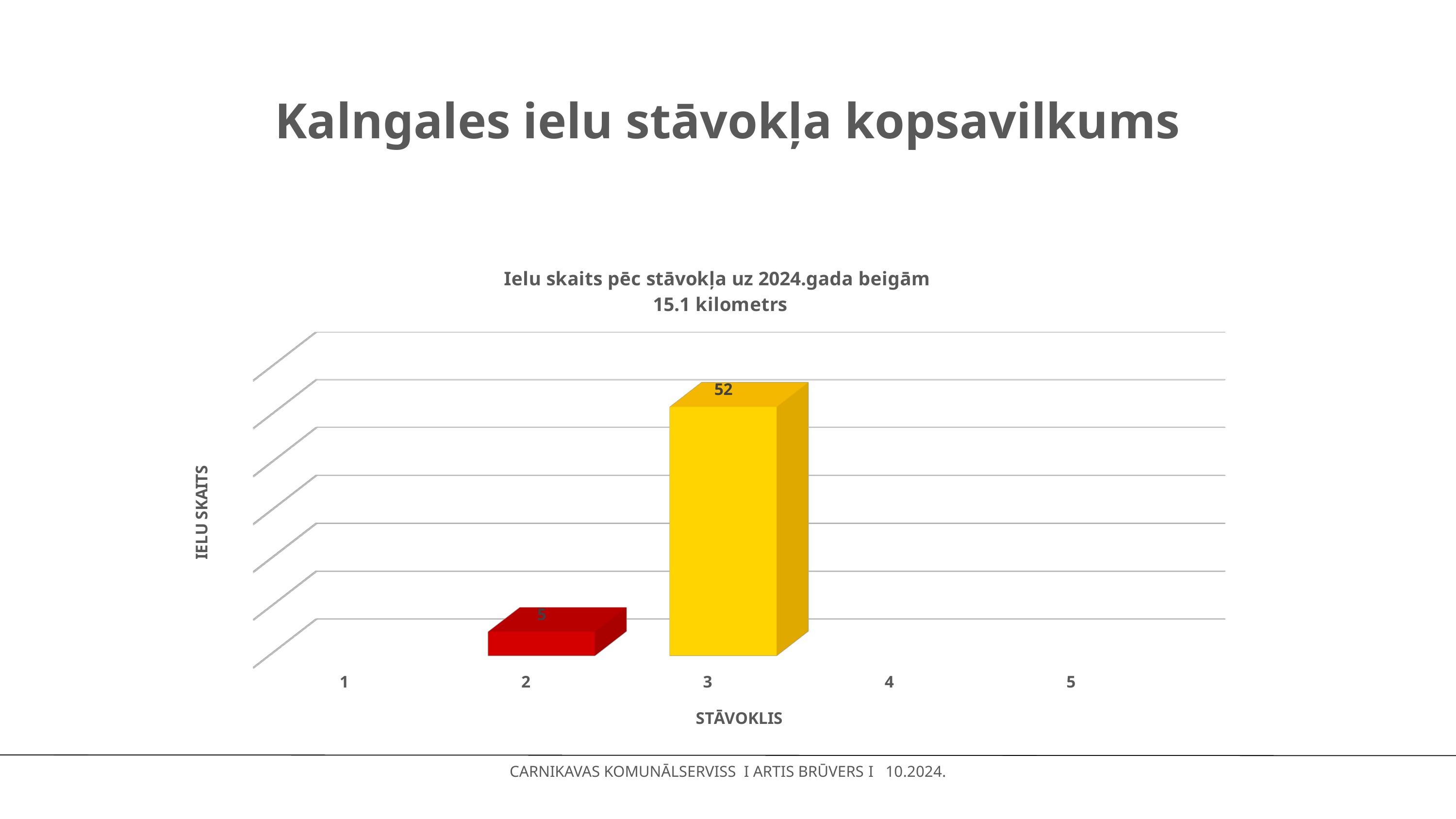
What is the difference between the values for category 3 and category 2? 47 What is the title of the chart? Ielu skaits pēc stāvokļa uz 2024.gada beigām 15.1 kilometrs What is the value for category 2 (stāvoklis 2)? 5 Which categories on the x axis have no bar plotted? 1, 4 and 5 Which is larger, the value for category 2 or the value for category 3? category 3 How many categories are shown on the x axis (STĀVOKLIS)? 5 What is the value for category 3 (stāvoklis 3)? 52 Which stāvoklis category has the highest number of streets (ielu skaits)? 3 What kind of chart is shown on the slide? bar chart What colour is the bar for category 3? yellow How many bars are plotted in the chart? 2